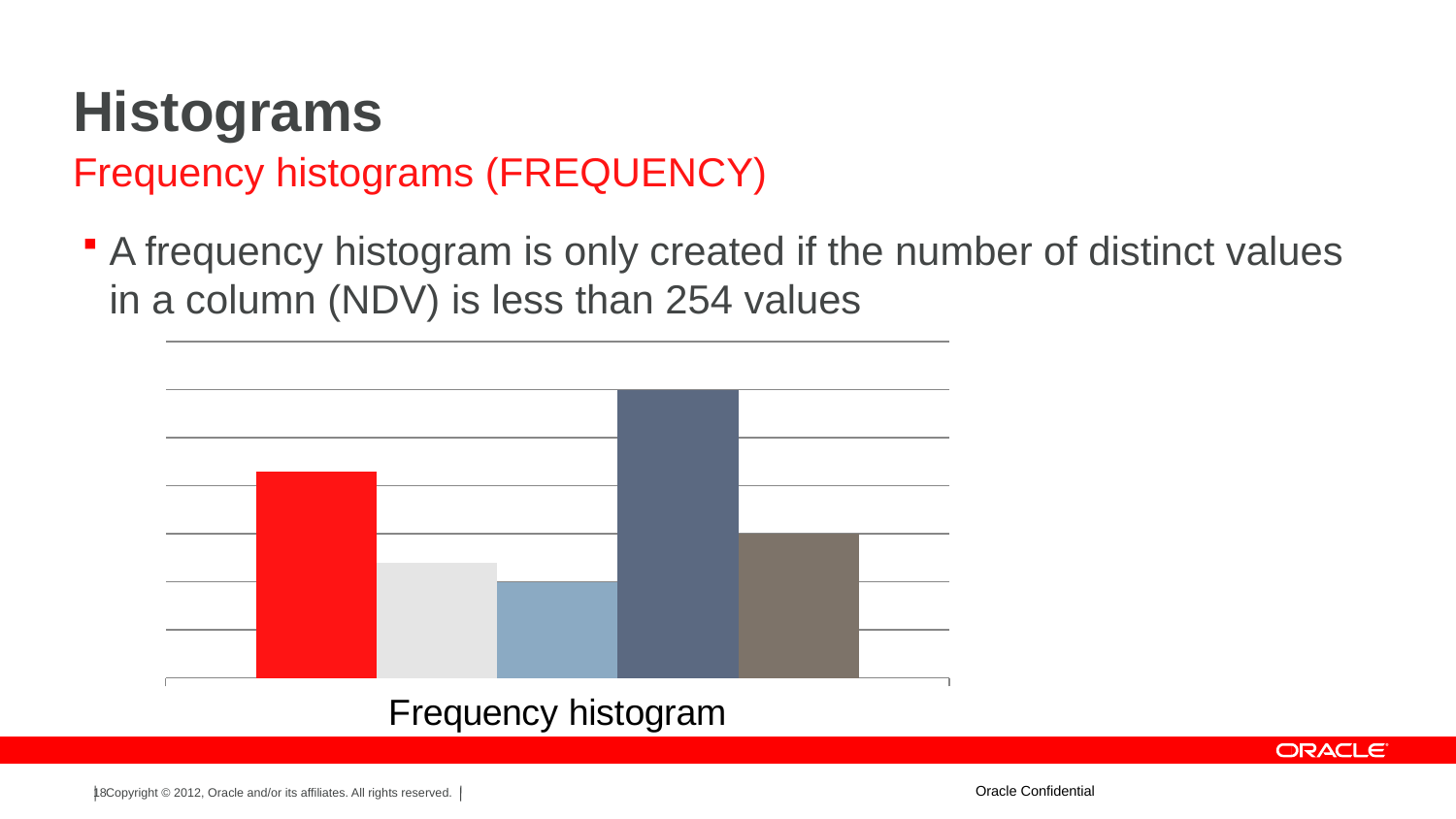
Which is taller, the second (light gray) bar or the third (light blue) bar? The second (light gray) bar Which bar is the tallest in the chart? The fourth bar (dark blue) Which bar is the shortest in the chart? The third bar (light blue) Which is taller, the second (light gray) bar or the fifth (brown) bar? The fifth (brown) bar What kind of chart is shown on the slide? Bar chart Which bar is the second tallest in the chart? The first bar (red) Which is taller, the first (red) bar or the fifth (brown) bar? The first (red) bar What is the caption shown beneath the chart? Frequency histogram How many bars does the chart contain? 5 What colour is the tallest bar in the chart? Dark blue